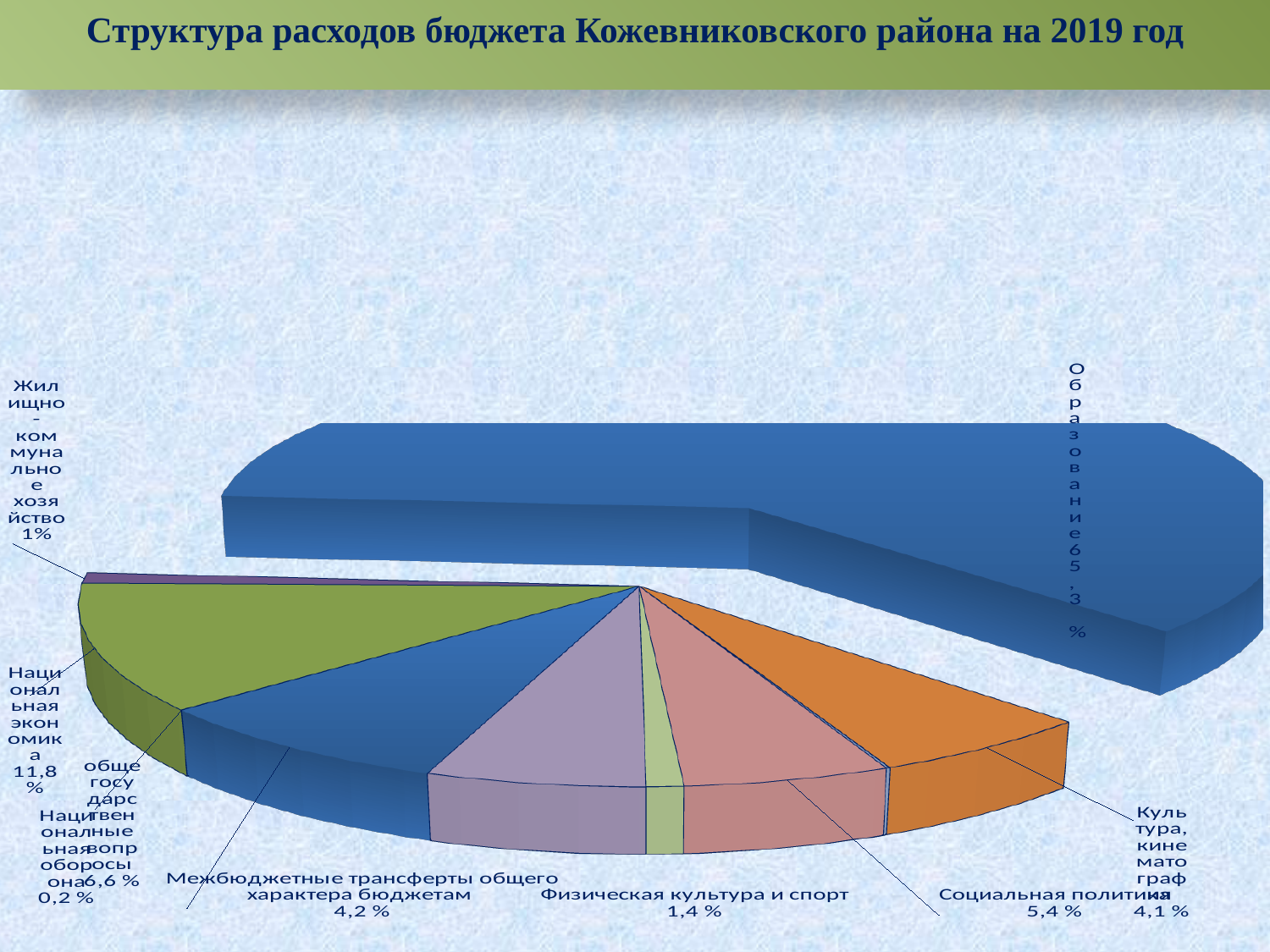
What share of the budget expenditure goes to Образование? 65,3 % Which category has the smallest share of the budget expenditure? Национальная оборона Which category has the largest share of the budget expenditure? Образование What share of the budget expenditure goes to Социальная политика? 5,4 % What kind of chart is shown on the slide? pie chart What share of the budget expenditure goes to Физическая культура и спорт? 1,4 % What is the title of the chart? Структура расходов бюджета Кожевниковского района на 2019 год What share of the budget expenditure goes to Межбюджетные трансферты общего характера бюджетам? 4,2 % What share of the budget expenditure goes to Национальная экономика? 11,8 % What share of the budget expenditure goes to Культура, кинематография? 4,1 %